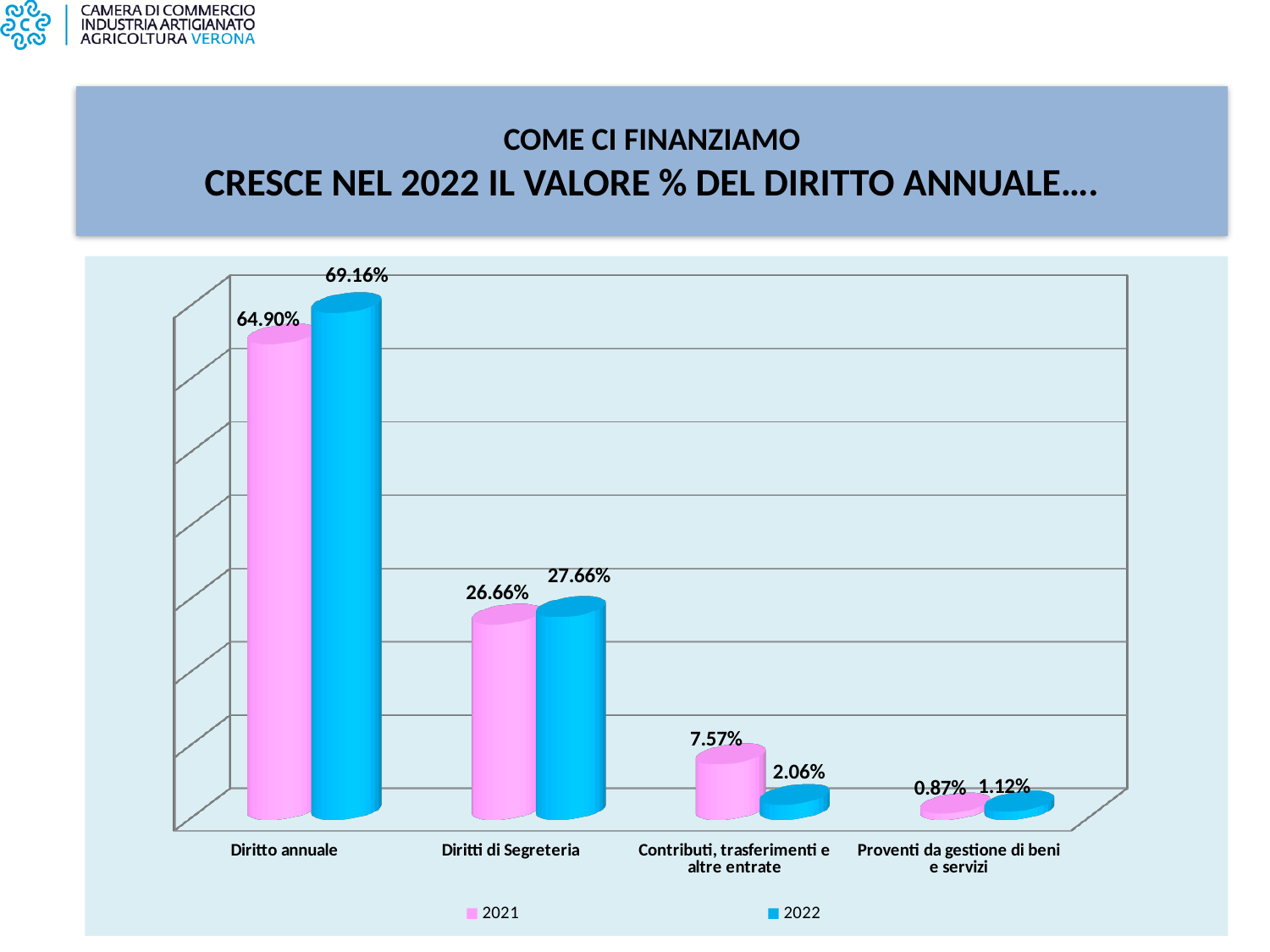
Which colour represents the 2022 series in the legend? Blue Which category has the highest value in 2022? Diritto annuale How many series does the legend list? 2 Which is larger for Contributi, trasferimenti e altre entrate: the 2021 value or the 2022 value? 2021 What is the value for Proventi da gestione di beni e servizi in 2021? 0.87% How many categories are shown on the x axis? 4 What kind of chart is shown on the slide? Bar chart Which category has the lowest value in 2021? Proventi da gestione di beni e servizi What is the value for Diritto annuale in 2022? 69.16% What is the difference between the 2022 and 2021 values for Diritto annuale? 4.26% What is the value for Diritti di Segreteria in 2021? 26.66% What is the value for Contributi, trasferimenti e altre entrate in 2022? 2.06%